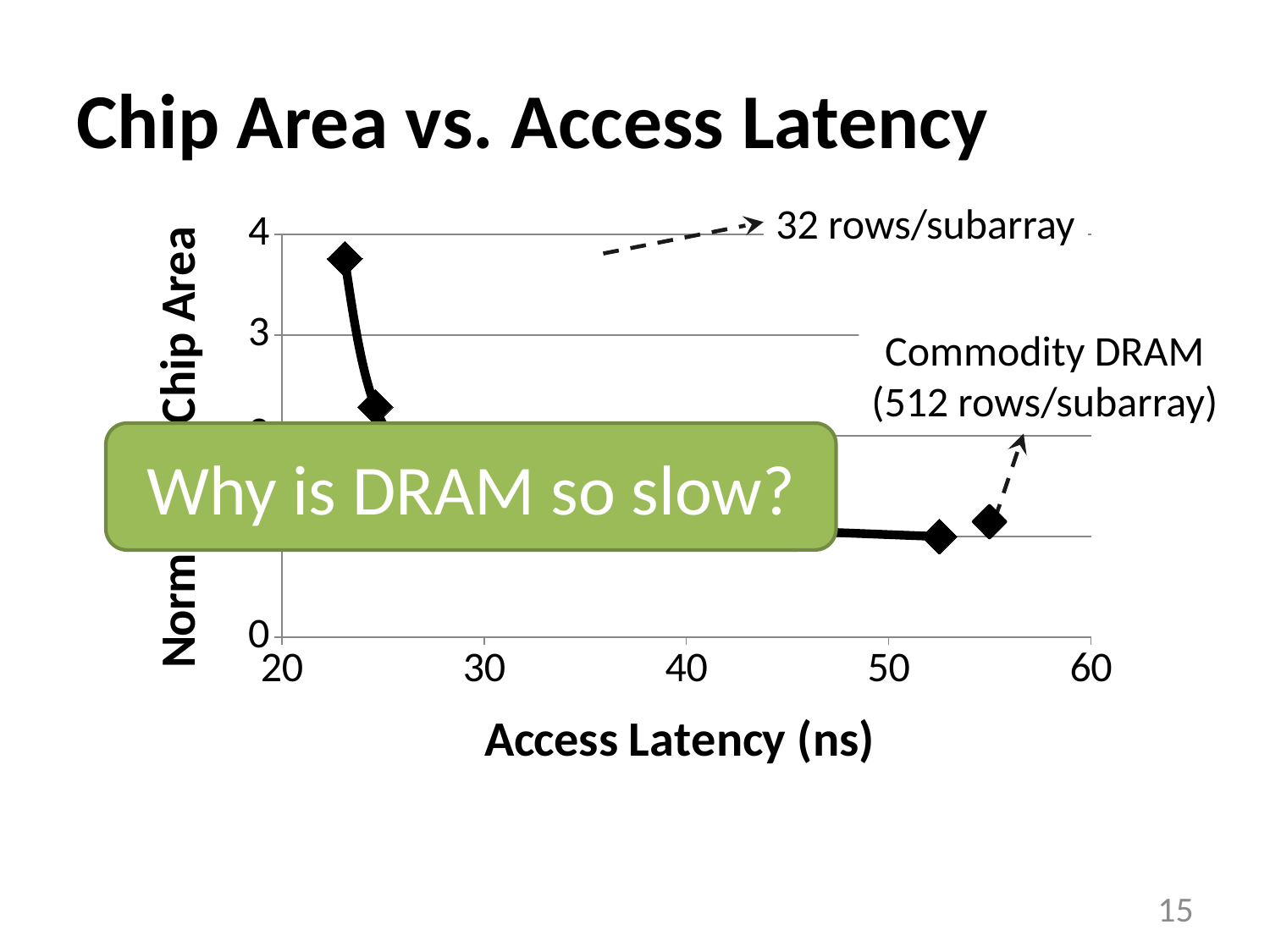
Is the normalized chip area for the Commodity DRAM (512 rows/subarray) point greater or less than 2? less What is the label of the x axis of the chart? Access Latency (ns) What is the title of the chart on the slide? Chip Area vs. Access Latency Which labeled configuration has the lowest access latency on the chart? 32 rows/subarray Is the access latency for the 32 rows/subarray point greater or less than 30 ns? less Is the normalized chip area for the 32 rows/subarray point greater or less than 3? greater Which labeled configuration has the higher normalized chip area, 32 rows/subarray or Commodity DRAM (512 rows/subarray)? 32 rows/subarray Which labeled configuration has the higher access latency, 32 rows/subarray or Commodity DRAM (512 rows/subarray)? Commodity DRAM (512 rows/subarray) What kind of chart is shown on the slide? line chart As access latency increases along the x axis, does the normalized chip area generally rise or fall? fall